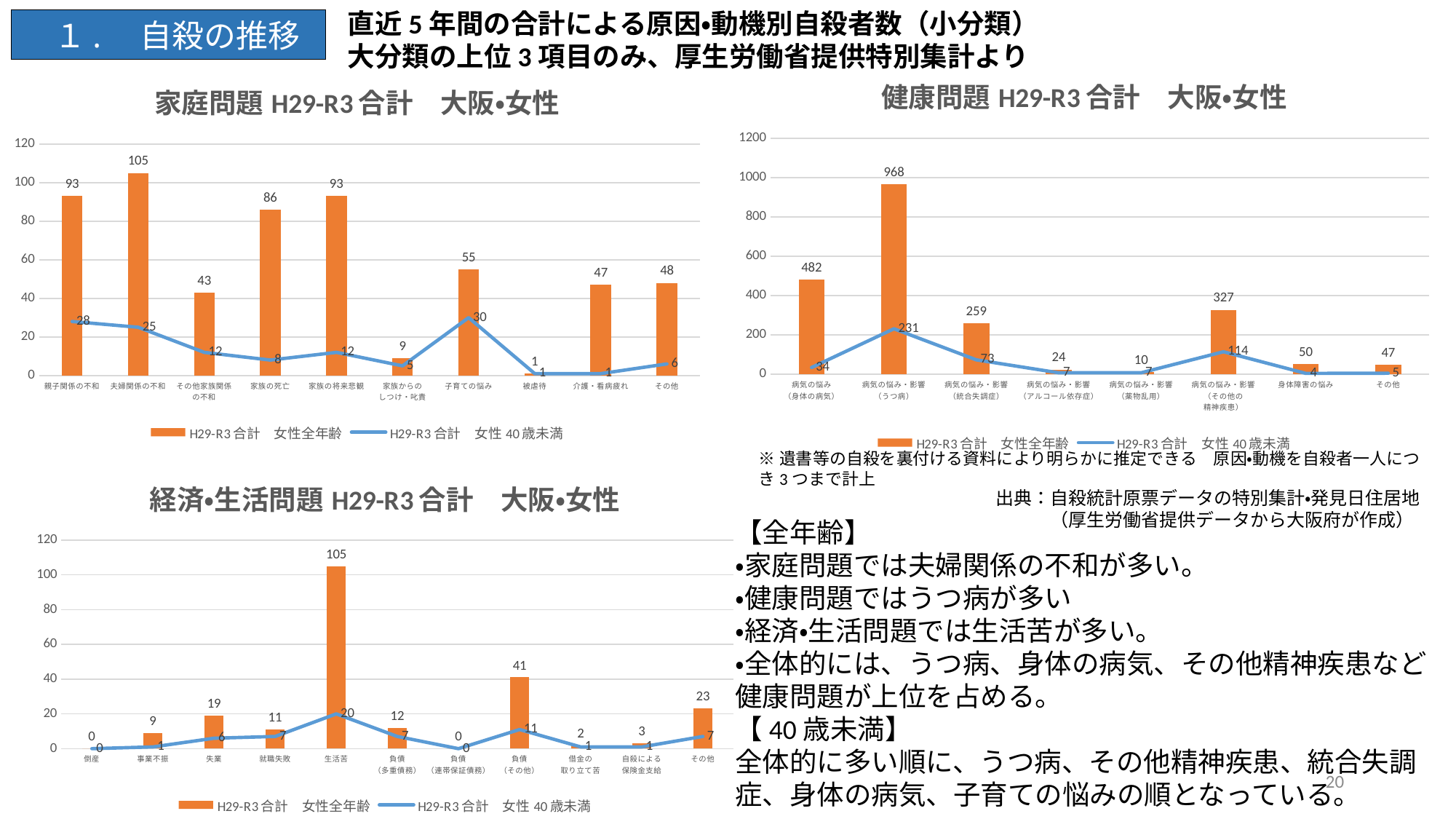
In the 経済•生活問題 H29-R3合計 大阪•女性 chart, how many series does the legend list? 2 In the 家庭問題 H29-R3合計 大阪•女性 chart, what is the difference between the 女性全年齢 values for 親子関係の不和 and その他家族関係の不和? 50 In the 家庭問題 H29-R3合計 大阪•女性 chart, what is the value of the 女性全年齢 bar for 夫婦関係の不和? 105 In the 健康問題 H29-R3合計 大阪•女性 chart, how many categories are shown on the x axis? 8 In the 家庭問題 H29-R3合計 大阪•女性 chart, which category has the highest 女性全年齢 bar? 夫婦関係の不和 In the 健康問題 H29-R3合計 大阪•女性 chart, what is the 女性40歳未満 value for 病気の悩み・影響（その他の精神疾患）? 114 In the 経済•生活問題 H29-R3合計 大阪•女性 chart, what is the total of the 女性全年齢 values for 事業不振 and 失業? 28 In the 健康問題 H29-R3合計 大阪•女性 chart, which category has the lowest 女性全年齢 bar? 病気の悩み・影響（薬物乱用） In the 健康問題 H29-R3合計 大阪•女性 chart, what is the 女性全年齢 value for 病気の悩み・影響（うつ病）? 968 In the 経済•生活問題 H29-R3合計 大阪•女性 chart, which is larger for 女性全年齢: 失業 or 負債（その他）? 負債（その他） In the 家庭問題 H29-R3合計 大阪•女性 chart, what is the 女性40歳未満 value for 子育ての悩み? 30 In the 経済•生活問題 H29-R3合計 大阪•女性 chart, what is the 女性全年齢 value for 生活苦? 105